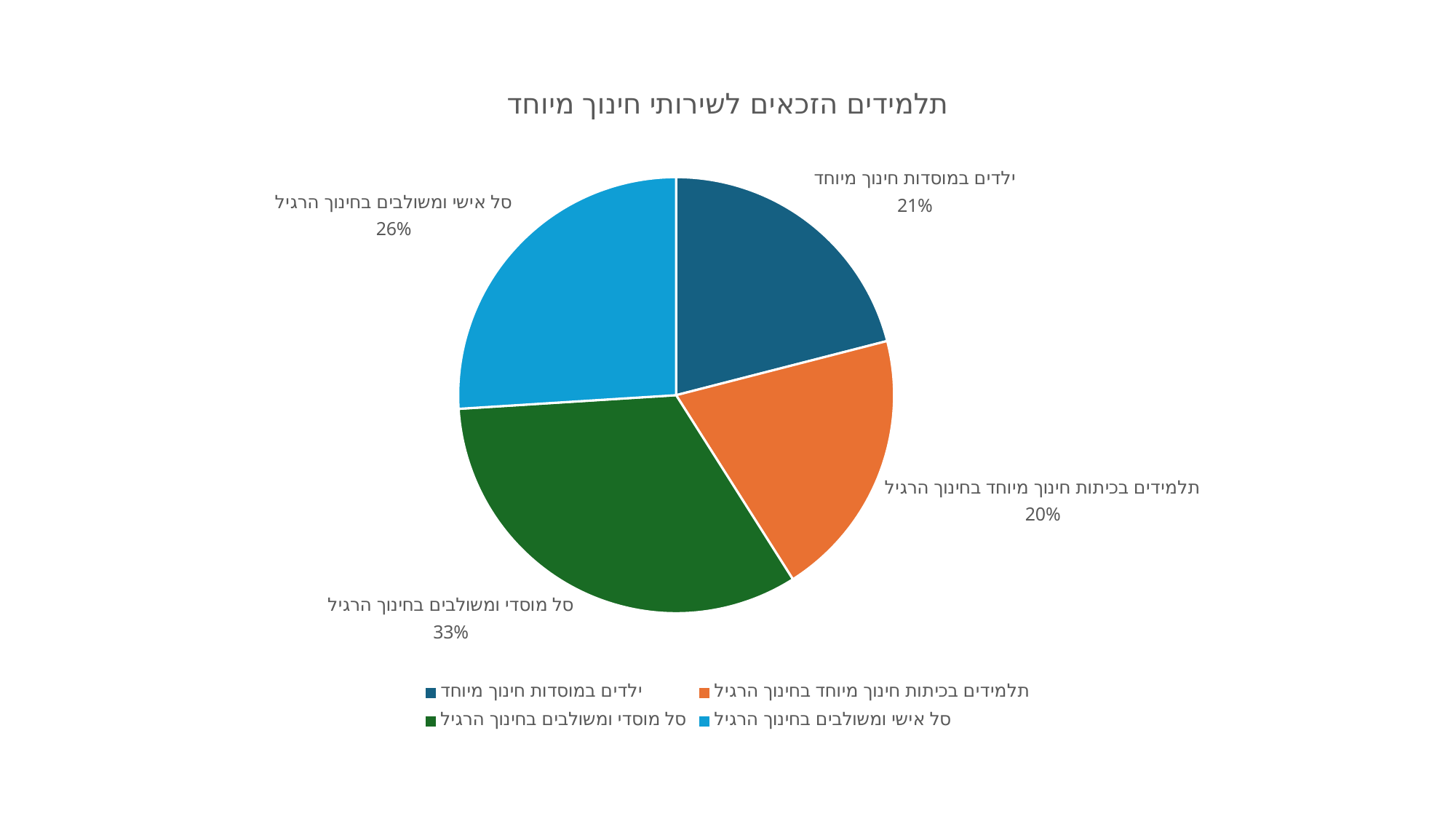
What percentage is shown for the slice "סל אישי ומשולבים בחינוך הרגיל"? 26% Which slice has the largest share of the pie? סל מוסדי ומשולבים בחינוך הרגיל Which slice has the smallest share of the pie? תלמידים בכיתות חינוך מיוחד בחינוך הרגיל What percentage is shown for the slice "סל מוסדי ומשולבים בחינוך הרגיל"? 33% How many slices does the pie chart have? 4 What percentage is shown for the slice "ילדים במוסדות חינוך מיוחד"? 21% What kind of chart is shown on the slide? pie chart Which is larger: the share for "סל אישי ומשולבים בחינוך הרגיל" or the share for "ילדים במוסדות חינוך מיוחד"? סל אישי ומשולבים בחינוך הרגיל What colour is the slice for "סל מוסדי ומשולבים בחינוך הרגיל"? green What is the title of the chart? תלמידים הזכאים לשירותי חינוך מיוחד What percentage is shown for the slice "תלמידים בכיתות חינוך מיוחד בחינוך הרגיל"? 20% What is the difference in percentage points between "סל מוסדי ומשולבים בחינוך הרגיל" and "סל אישי ומשולבים בחינוך הרגיל"? 7